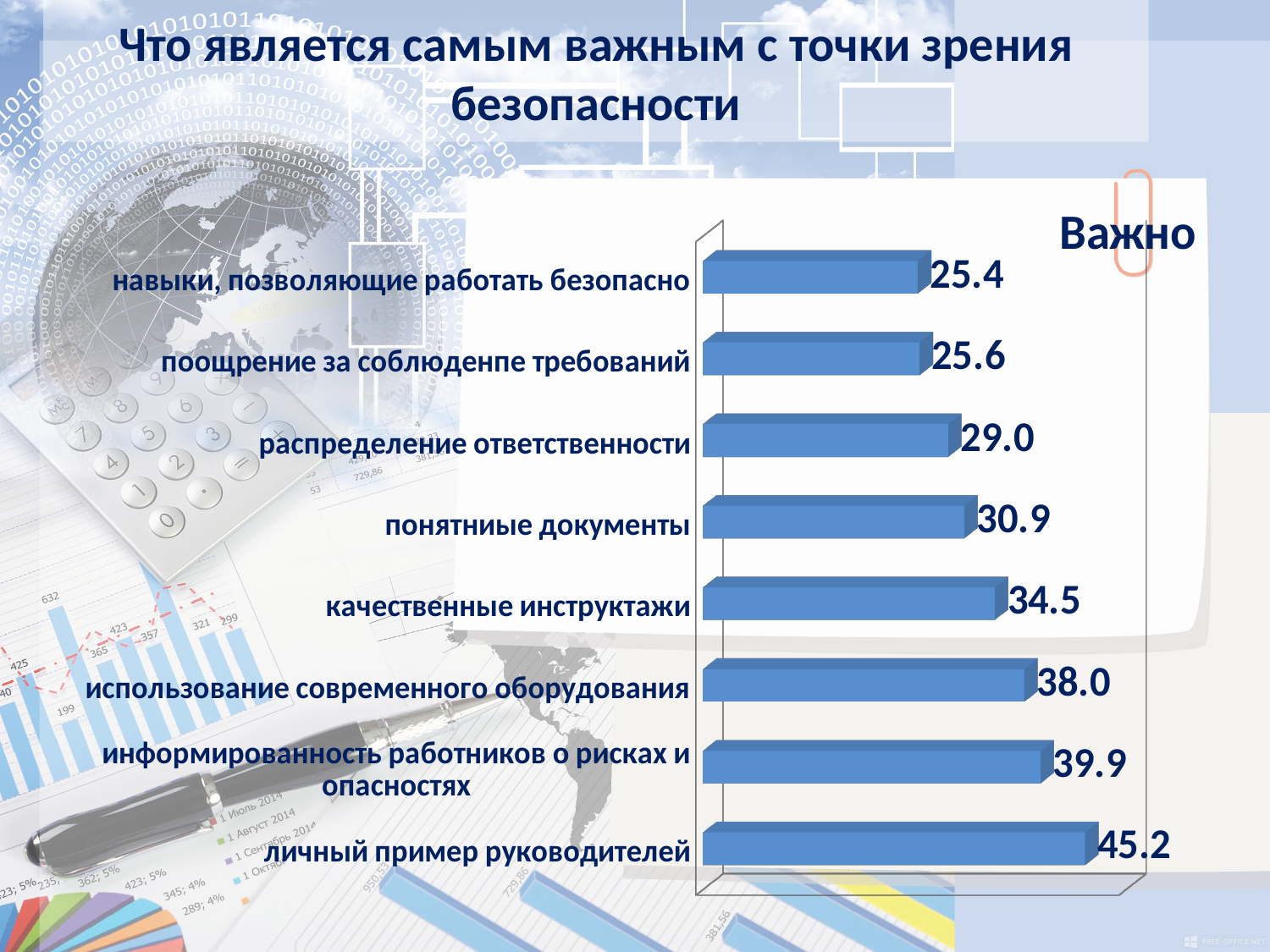
What is the value for "качественные инструктажи"? 34.5 What is the difference between the values for "личный пример руководителей" and "использование современного оборудования"? 7.2 Which category has the lowest value? навыки, позволяющие работать безопасно What is the value for "распределение ответственности"? 29.0 What type of chart is shown on the slide? bar chart What is the difference between the values for "понятниые документы" and "распределение ответственности"? 1.9 Which is larger: the value for "качественные инструктажи" or the value for "понятниые документы"? качественные инструктажи Which category has the highest value? личный пример руководителей What is the value for "информированность работников о рисках и опасностях"? 39.9 What is the value for "личный пример руководителей"? 45.2 How many categories are shown in the chart? 8